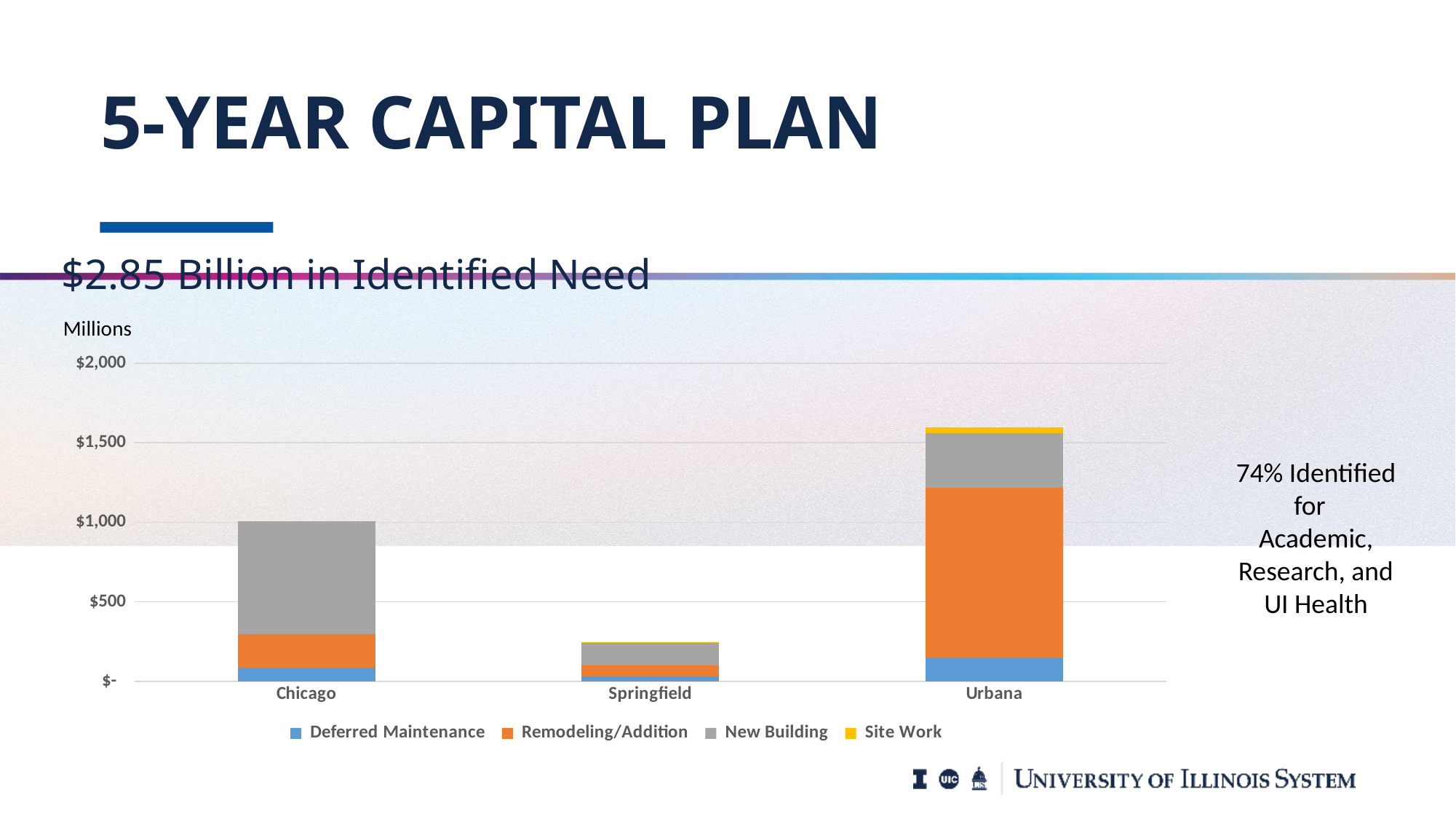
What is the title of the chart? $2.85 Billion in Identified Need Which campus has the tallest stacked bar in the chart? Urbana How many campuses (categories) are shown on the x axis of the chart? 3 Which campus has a larger total identified need, Chicago or Springfield? Chicago Is the total stacked bar for Urbana greater or less than $1,500? greater Is the total stacked bar for Chicago greater or less than $500? greater Which campus has the shortest stacked bar in the chart? Springfield Is the total stacked bar for Springfield greater or less than $500? less What kind of chart is shown on the slide? Stacked bar chart How many series does the chart's legend list? 4 Which campus has a larger total identified need, Chicago or Urbana? Urbana Which legend entry is shown in orange? Remodeling/Addition